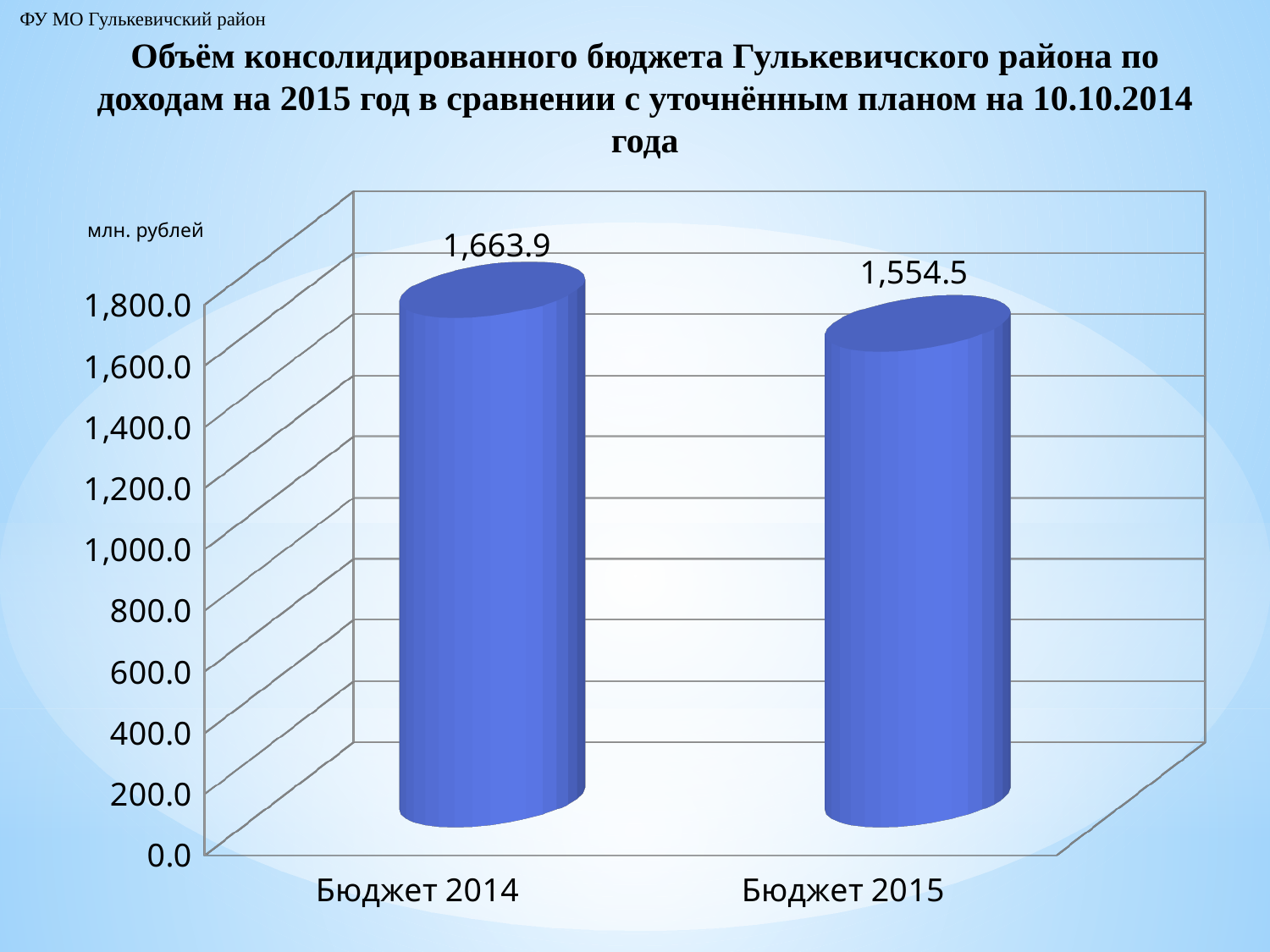
Which is larger, the value for Бюджет 2014 or Бюджет 2015? Бюджет 2014 What kind of chart is shown on the slide? bar chart Which category has the lowest value? Бюджет 2015 What unit is indicated for the values on the chart? млн. рублей What is the value for Бюджет 2015? 1,554.5 What is the difference between the values for Бюджет 2014 and Бюджет 2015? 109.4 Is the value for Бюджет 2014 greater or less than 1,600.0? greater Do the values rise or fall from Бюджет 2014 to Бюджет 2015? fall What is the value for Бюджет 2014? 1,663.9 Which category has the highest value? Бюджет 2014 How many categories are shown on the x axis? 2 Is the value for Бюджет 2015 greater or less than 1,600.0? less